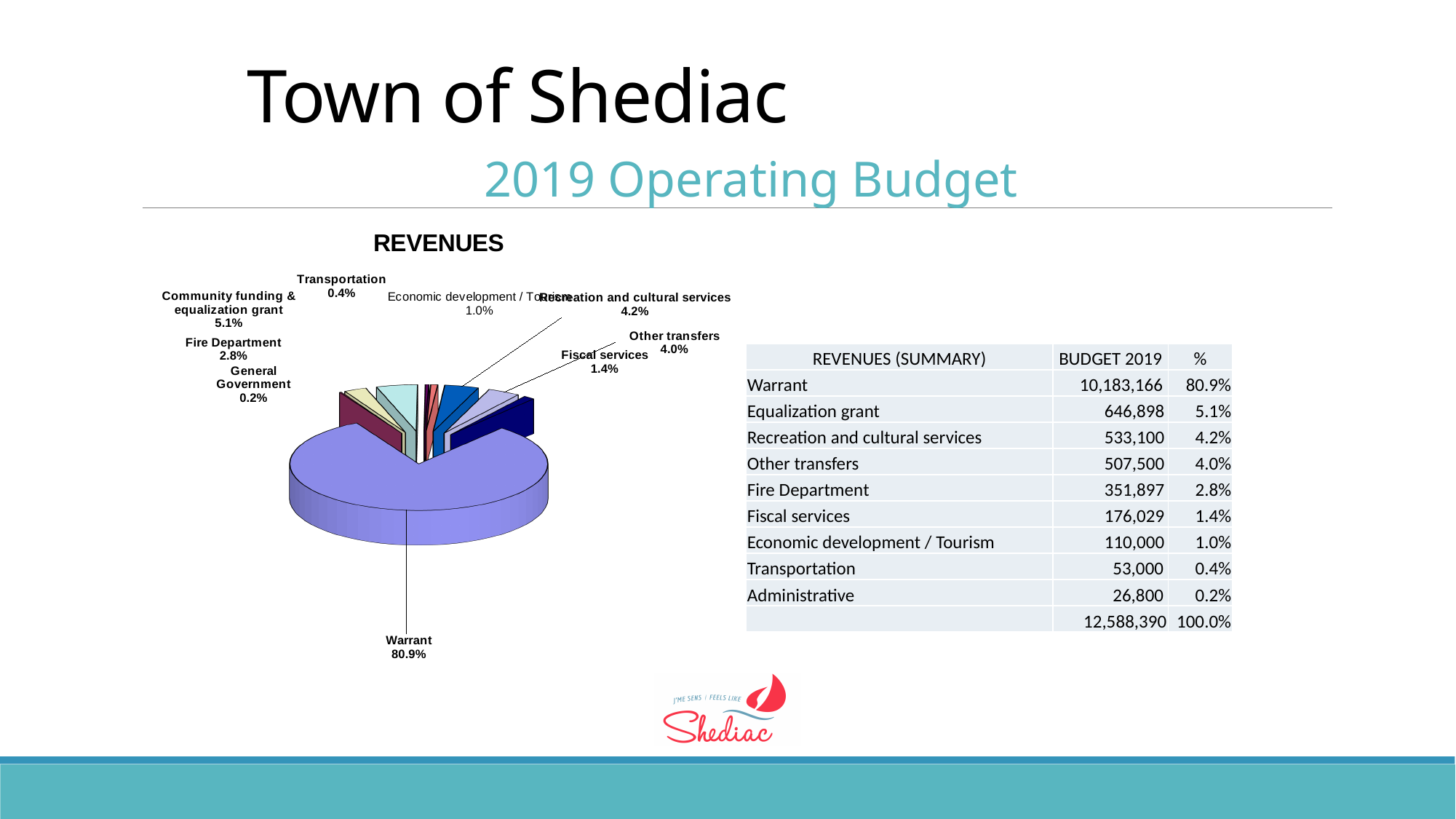
Which slice of the REVENUES pie chart is the largest? Warrant What percentage is shown for Fire Department in the pie chart? 2.8% Which slice of the REVENUES pie chart is the smallest? General Government What kind of chart is shown under the title REVENUES? Pie chart What is the difference in percentage points between Community funding & equalization grant and Fire Department in the pie chart? 2.3 What share of revenues does the Warrant slice represent in the pie chart? 80.9% What is the difference in percentage points between Recreation and cultural services and Other transfers in the pie chart? 0.2 What percentage is shown for Transportation in the pie chart? 0.4% What percentage is shown for Recreation and cultural services in the pie chart? 4.2% In the pie chart, which is larger: Other transfers or Fiscal services? Other transfers How many slices does the REVENUES pie chart have? 9 What is the title of the pie chart on the slide? REVENUES